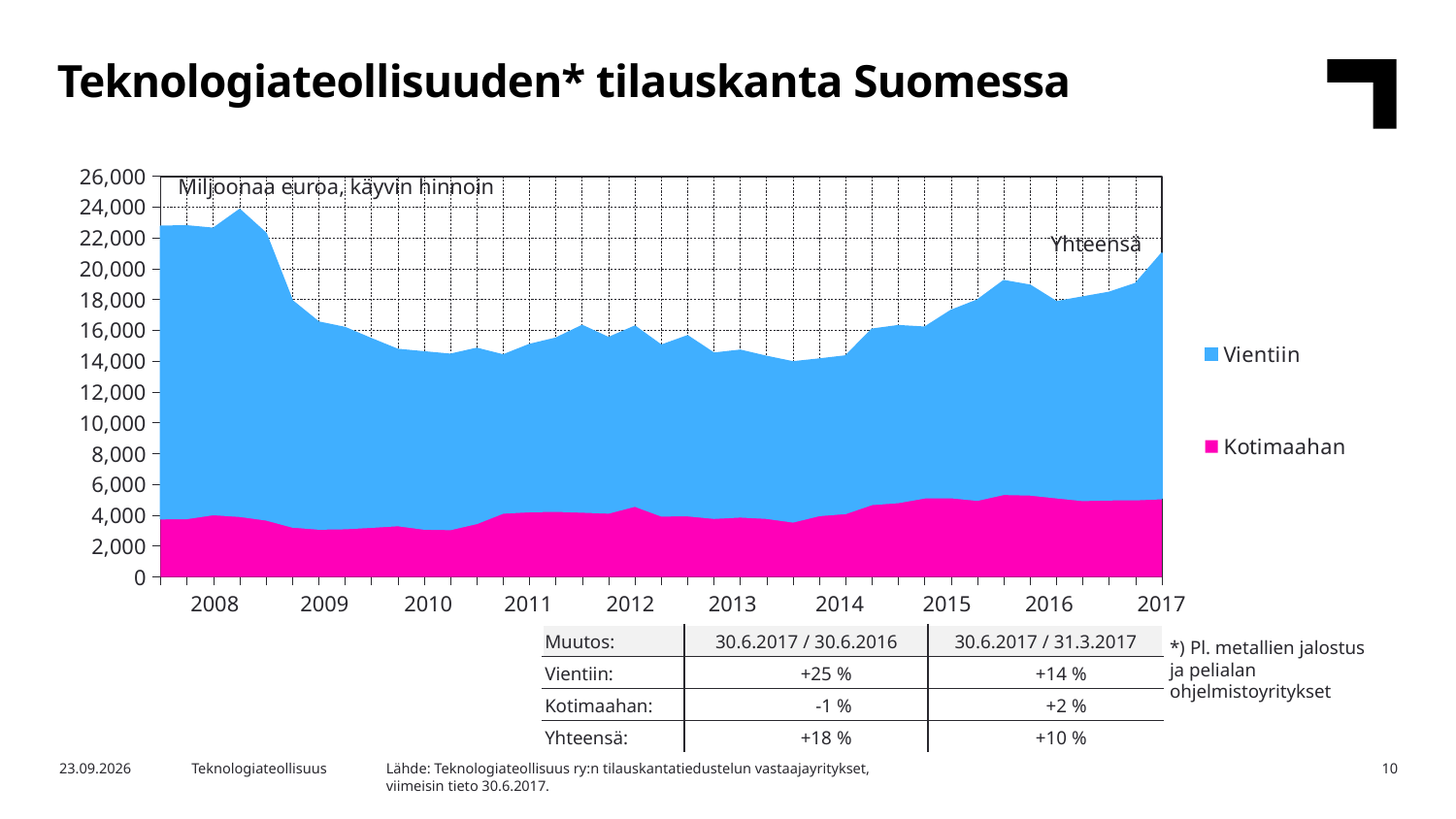
Which two series are listed in the chart legend? Vientiin and Kotimaahan Which series is larger throughout the chart, Vientiin or Kotimaahan? Vientiin What unit label is shown inside the chart area? Miljoonaa euroa, käyvin hinnoin How many year labels are shown on the x axis? 10 Does the total order book (Yhteensä) rise or fall from 2008 to 2010? Fall Is the total (Yhteensä) value at the start of 2008 greater or less than 20,000? greater Is the Kotimaahan value in 2010 greater or less than 4,000? less Is the total (Yhteensä) value at the end of 2017 greater or less than 20,000? greater How many series does the legend list? 2 What kind of chart is shown on the slide? Area chart